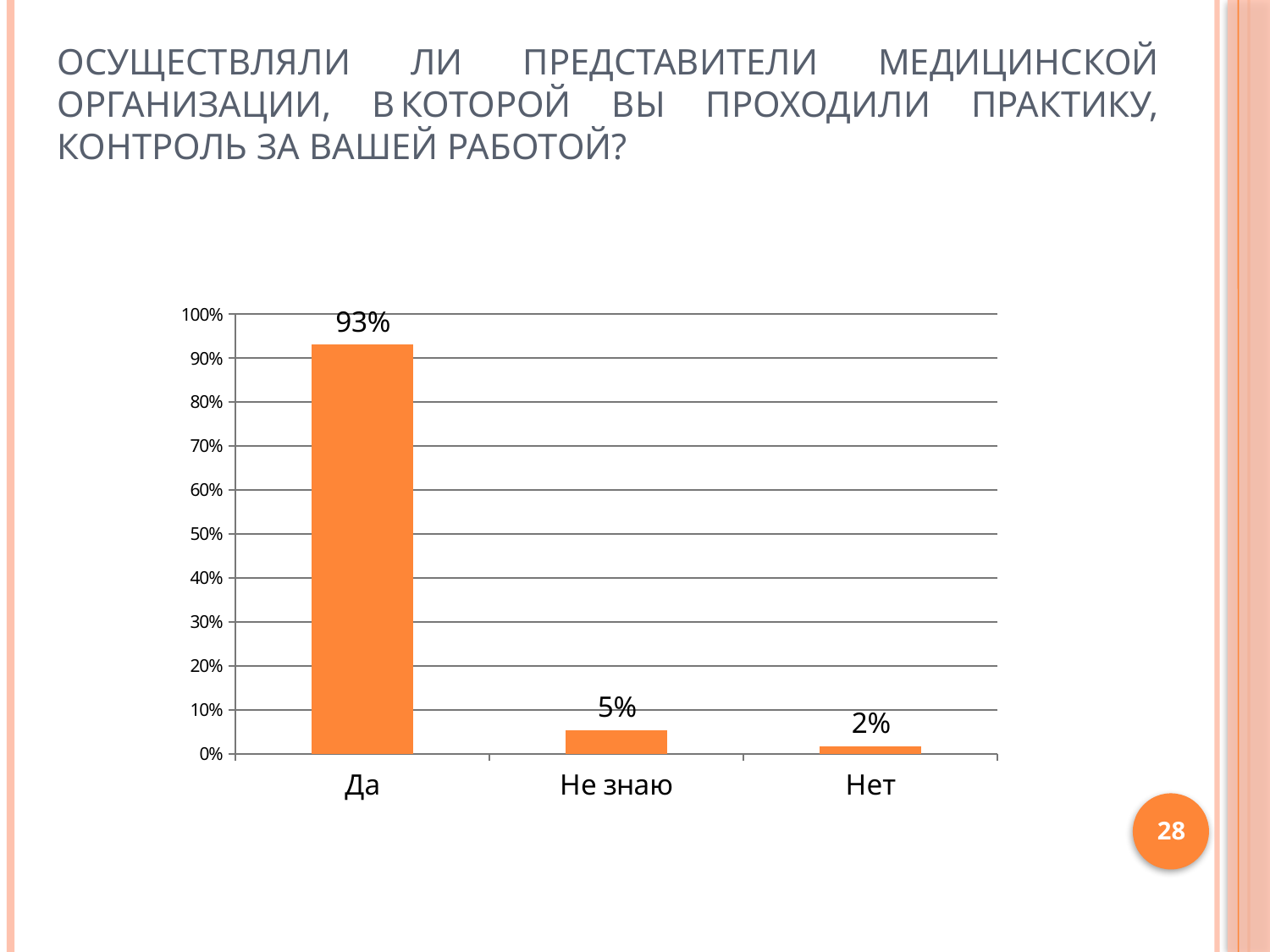
Which is larger, the value for "Не знаю" or the value for "Нет"? Не знаю Is the value for "Да" greater or less than 90%? greater What kind of chart is shown on the slide? bar chart Do the values rise or fall from left to right along the x axis? fall Which category has the highest value? Да How many categories are shown on the x axis? 3 What is the difference between the values for "Да" and "Не знаю"? 88% What is the value for "Да"? 93% What is the value for "Нет"? 2% Which category has the lowest value? Нет What is the value for "Не знаю"? 5% What is the difference between the values for "Не знаю" and "Нет"? 3%